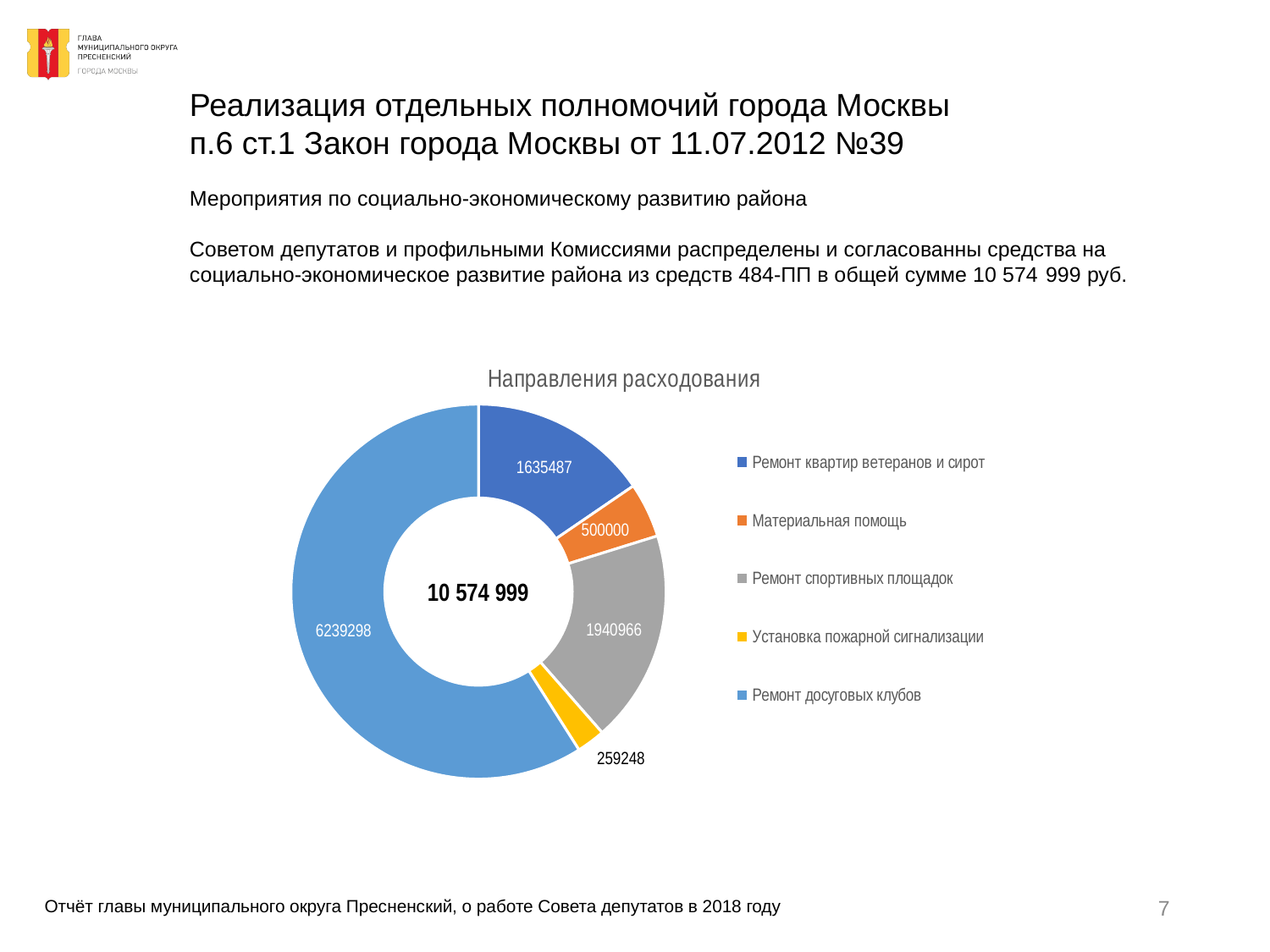
What is the value for "Ремонт квартир ветеранов и сирот"? 1635487 What is the value for "Материальная помощь"? 500000 What is the value for "Установка пожарной сигнализации"? 259248 Which is larger: the value for "Материальная помощь" or for "Установка пожарной сигнализации"? Материальная помощь What total is shown in the centre of the doughnut chart? 10 574 999 What is the value for "Ремонт досуговых клубов"? 6239298 What is the difference between the values for "Ремонт спортивных площадок" and "Ремонт квартир ветеранов и сирот"? 305479 What type of chart is shown under the title "Направления расходования"? doughnut chart Which category has the largest value? Ремонт досуговых клубов What is the value for "Ремонт спортивных площадок"? 1940966 Which category has the smallest value? Установка пожарной сигнализации How many categories does the chart show? 5